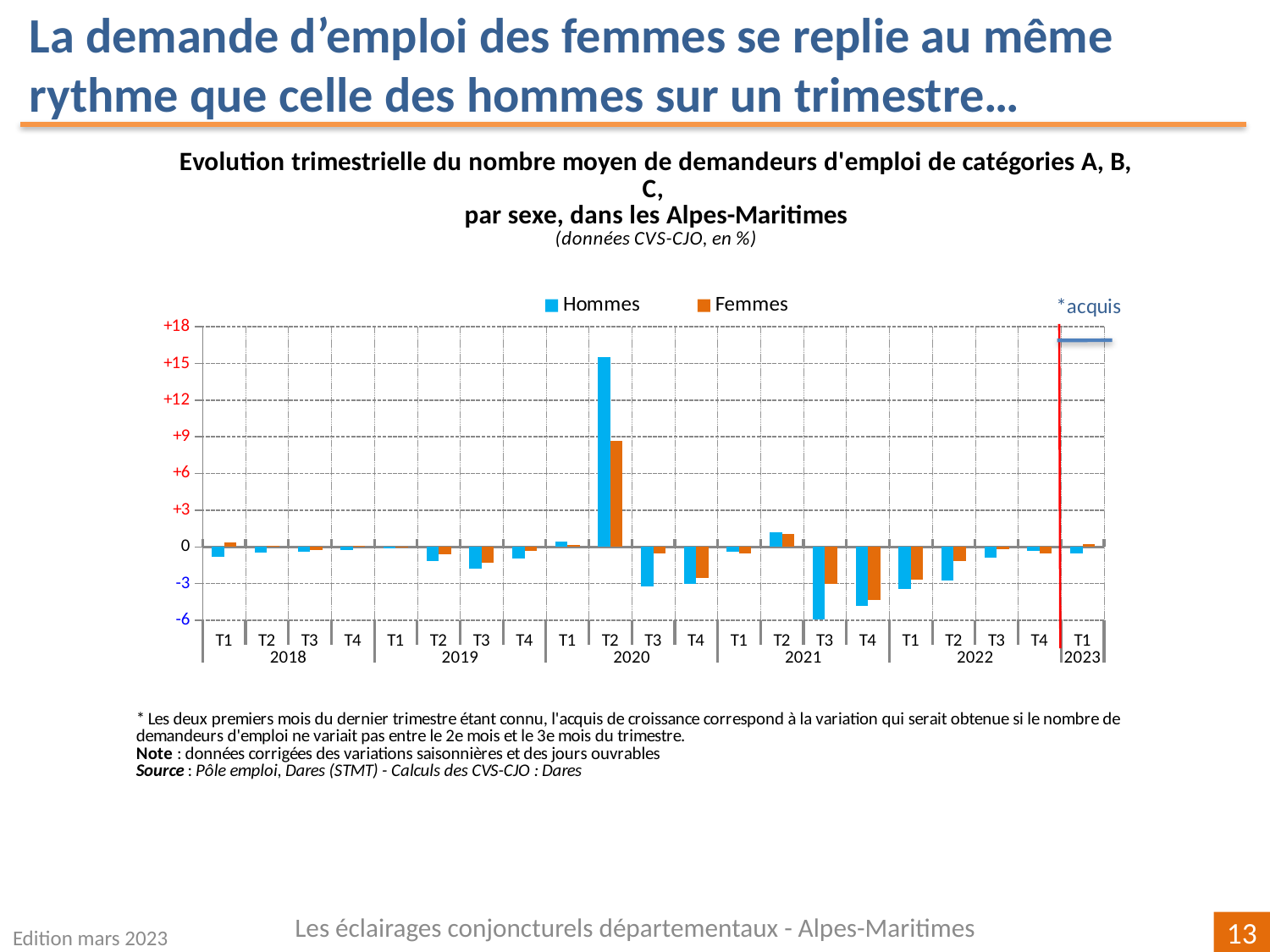
How many series does the legend list? 2 In T2 2020, which series has the larger value, Hommes or Femmes? Hommes Is the Hommes value for T2 2020 greater or less than +12? greater In which quarter is the Femmes value highest? T2 2020 In which quarter is the Hommes value lowest? T3 2021 What kind of chart is shown on the slide? bar chart Is the Femmes value for T2 2020 greater or less than +6? greater In which quarter is the Femmes value lowest? T4 2021 How many quarters are plotted along the x axis? 21 In which quarter is the Hommes value highest? T2 2020 Which two series are shown in the legend? Hommes and Femmes Is the Hommes value for T3 2021 greater or less than -3? less